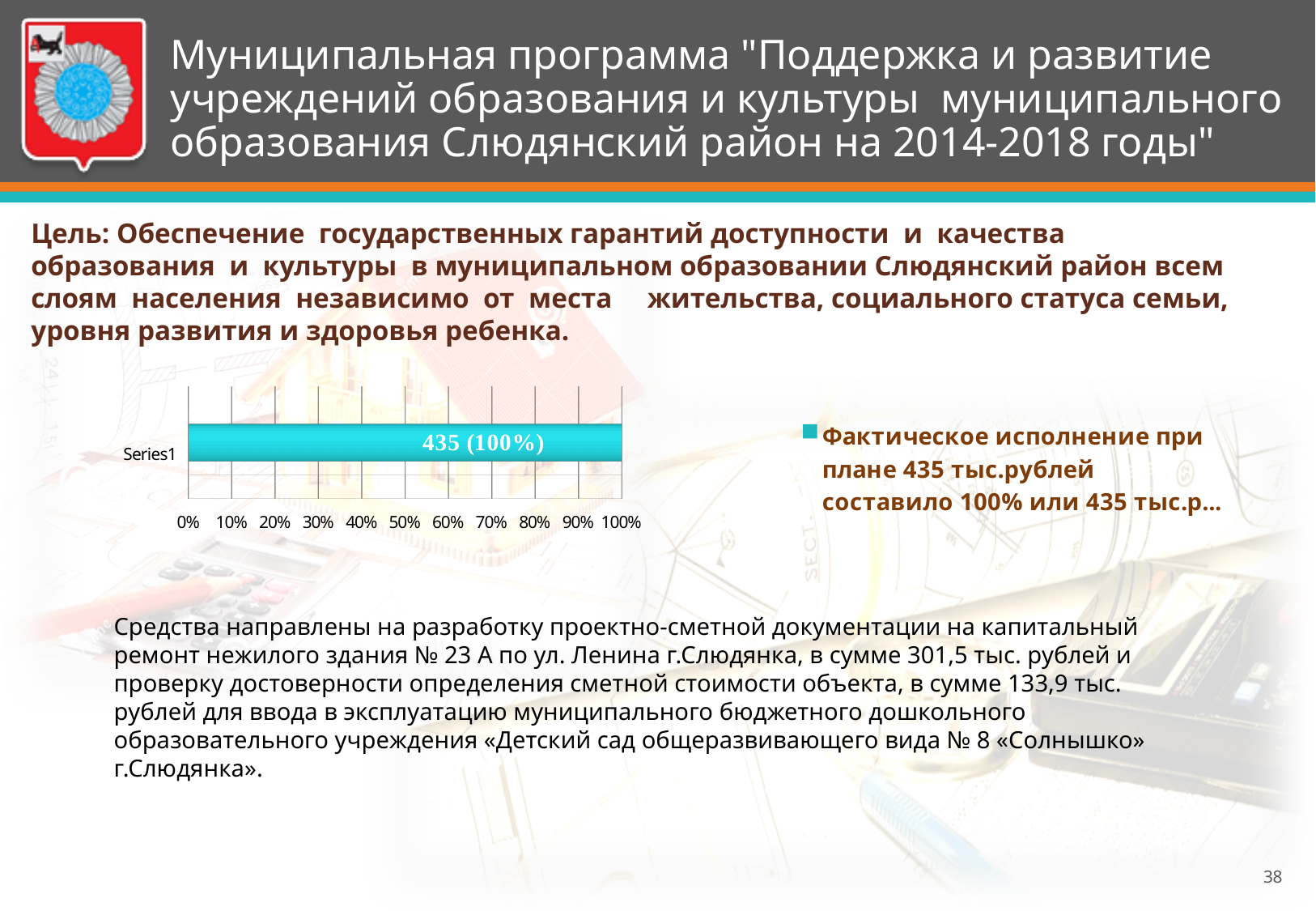
What kind of chart is shown on the slide? bar chart What is the highest value shown on the horizontal axis of the chart? 100% Is the value for Series1 greater or less than 50%? greater What is the category label shown on the vertical axis of the chart? Series1 Is the value for Series1 greater or less than 90%? greater What is the lowest tick value shown on the horizontal axis of the chart? 0% What is the data label printed on the bar for Series1? 435 (100%) How many bars does the chart contain? 1 What percentage does the bar for Series1 reach on the horizontal axis? 100%